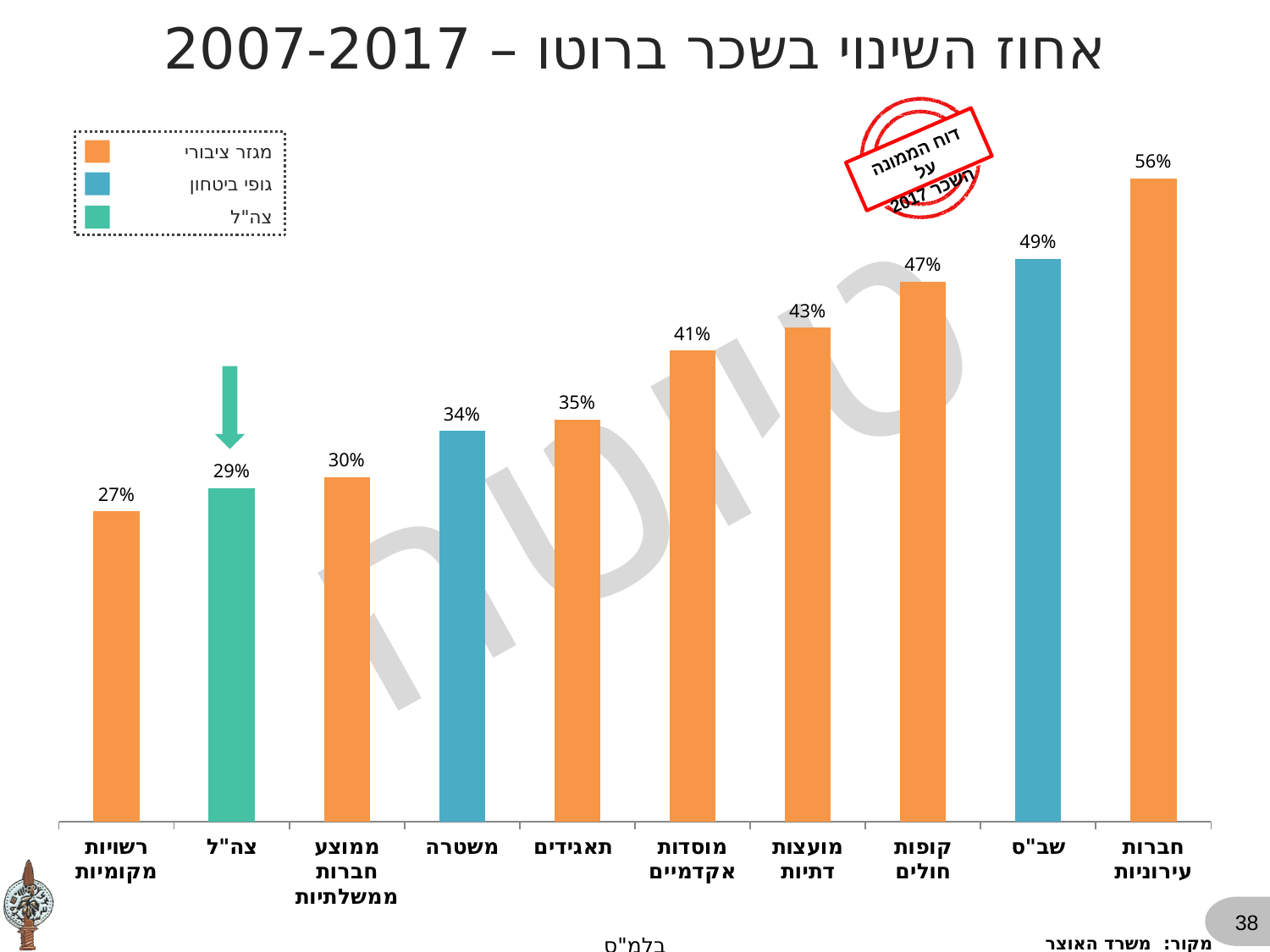
What kind of chart is shown on the slide? bar chart What is the value for מוסדות אקדמיים? 41% How many entries does the legend list? 3 Which category has the lowest value? רשויות מקומיות What is the value for שב"ס? 49% Which category has the highest value? חברות עירוניות Which legend entry is shown in green? צה"ל What is the difference between the values for קופות חולים and משטרה? 13% What is the difference between the values for חברות עירוניות and רשויות מקומיות? 29% Which is larger, the value for מועצות דתיות or the value for תאגידים? מועצות דתיות What is the value for צה"ל? 29% How many categories are shown on the chart? 10